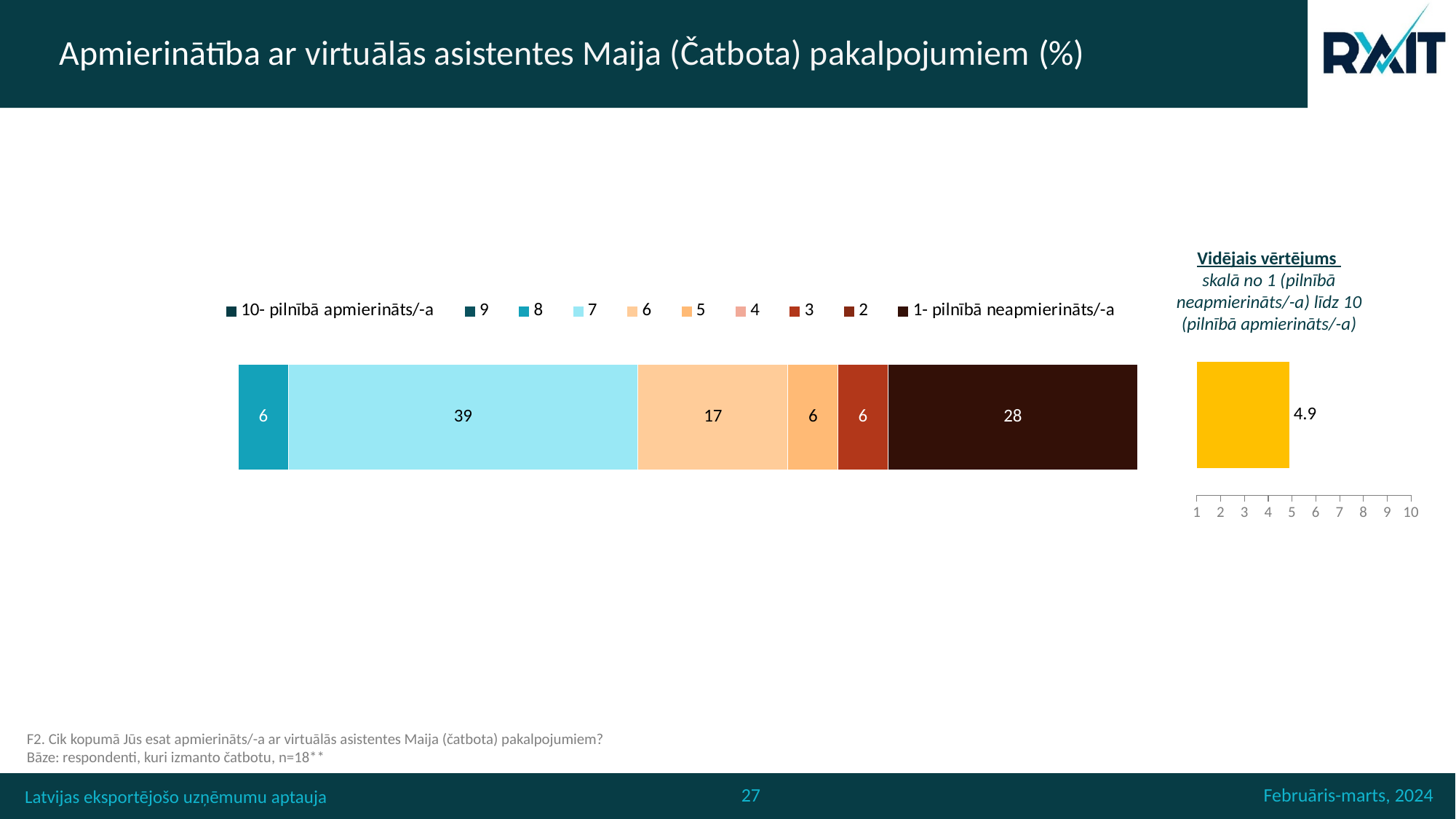
How many entries does the legend of the stacked bar chart list? 10 In the stacked bar chart, what percentage of respondents gave a rating of 6? 17 In the stacked bar chart, which is larger: the share for rating 6 or the share for rating 1? rating 1 In the 'Vidējais vērtējums' chart on the right, what is the average rating shown? 4.9 In the stacked bar chart, what percentage of respondents gave a rating of 1 (pilnībā neapmierināts/-a)? 28 In the stacked bar chart, what percentage of respondents gave a rating of 8? 6 In the stacked bar chart, what percentage of respondents gave a rating of 7? 39 In the stacked bar chart, what is the difference between the share for rating 6 and the share for rating 5? 11 What kind of chart is the main chart on the slide? stacked bar chart In the stacked bar chart, what is the difference between the share for rating 7 and the share for rating 1? 11 In the stacked bar chart, which rating has the largest share of respondents? 7 In the 'Vidējais vērtējums' chart on the right, is the average rating greater or less than 5? less